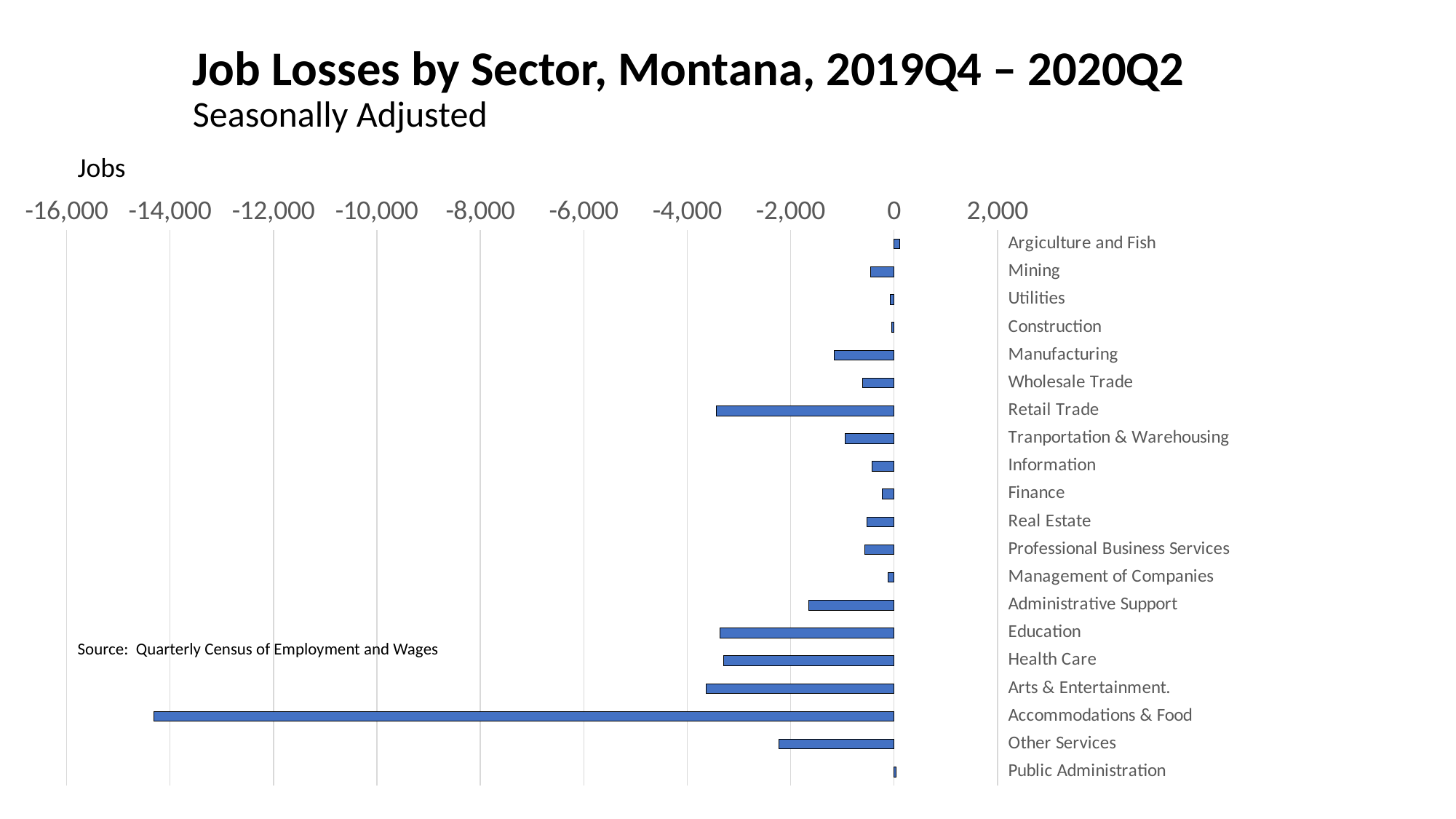
What is the title of the chart? Job Losses by Sector, Montana, 2019Q4 – 2020Q2 Which sector lost more jobs, Accommodations & Food or Health Care? Accommodations & Food What kind of chart is shown on the slide? bar chart Is the value for Other Services greater or less than -2,000? less How many sectors are plotted in the chart? 20 What is the data source cited on the slide? Quarterly Census of Employment and Wages Is the value for Retail Trade greater or less than -4,000? greater Which sector lost more jobs, Manufacturing or Wholesale Trade? Manufacturing Which sector lost more jobs, Retail Trade or Other Services? Retail Trade Is the value for Administrative Support greater or less than -2,000? greater Which sector shows the largest job loss? Accommodations & Food